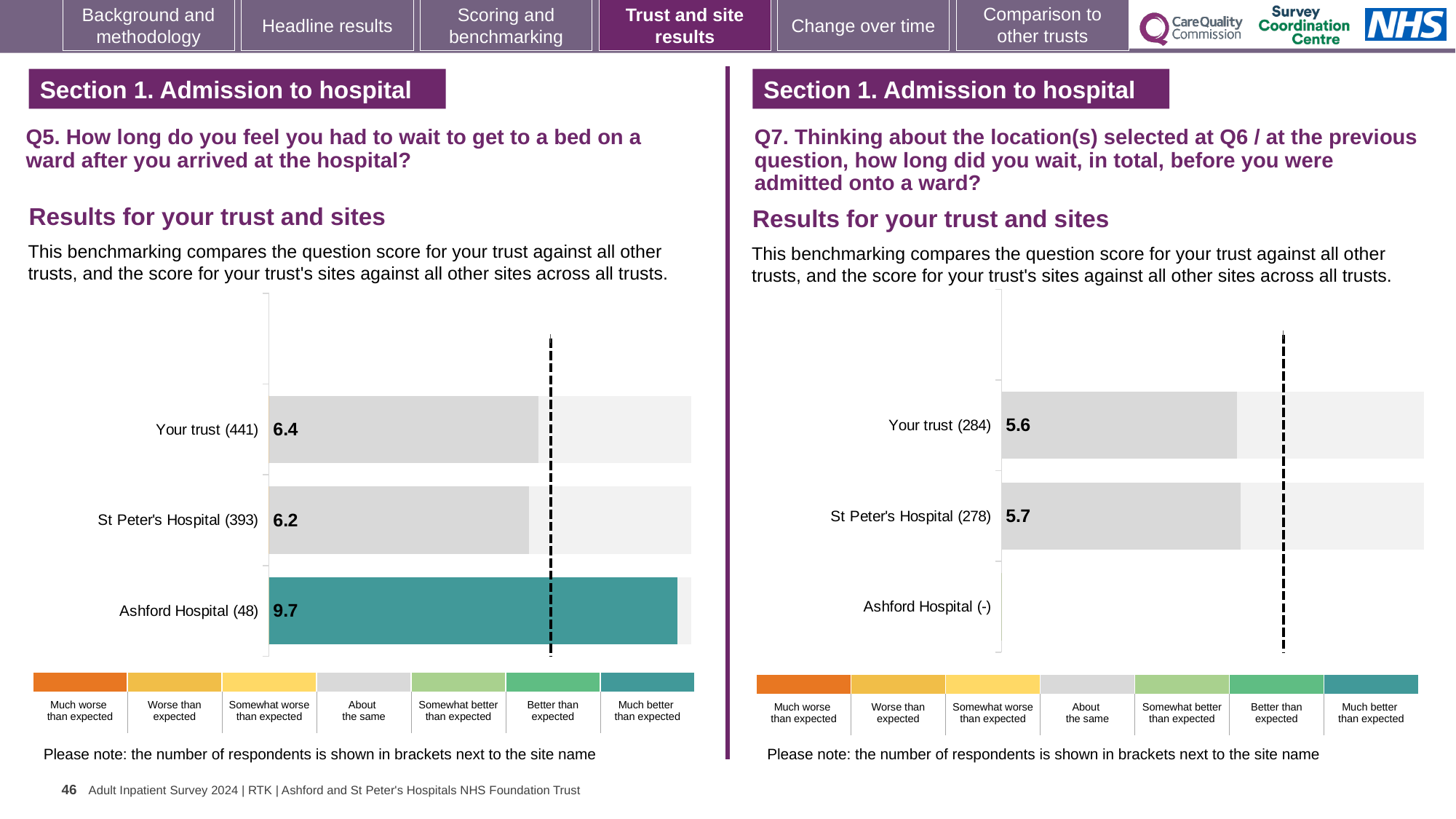
What type of chart is used on the left for Q5? Bar chart In the Q5 chart on the left, which benchmark category does the colour of the Ashford Hospital bar correspond to? Much better than expected In the Q5 chart on the left, what is the score for Ashford Hospital (48)? 9.7 In the Q5 chart on the left, what is the difference between the scores for Ashford Hospital and St Peter's Hospital? 3.5 In the Q7 chart on the right, what is the score for Your trust (284)? 5.6 In the Q7 chart on the right, how many respondents are shown for Your trust? 284 In the Q5 chart on the left, how many bars are plotted? 2 In the Q7 chart on the right, what is the score for St Peter's Hospital (278)? 5.7 In the Q7 chart on the right, what is the difference between the scores for St Peter's Hospital and Your trust? 0.1 In the Q5 chart on the left, what is the score for Your trust (441)? 6.4 In the Q5 chart on the left, which site or trust has the highest score? Ashford Hospital (48) In the Q5 chart on the left, what is the score for St Peter's Hospital (393)? 6.2